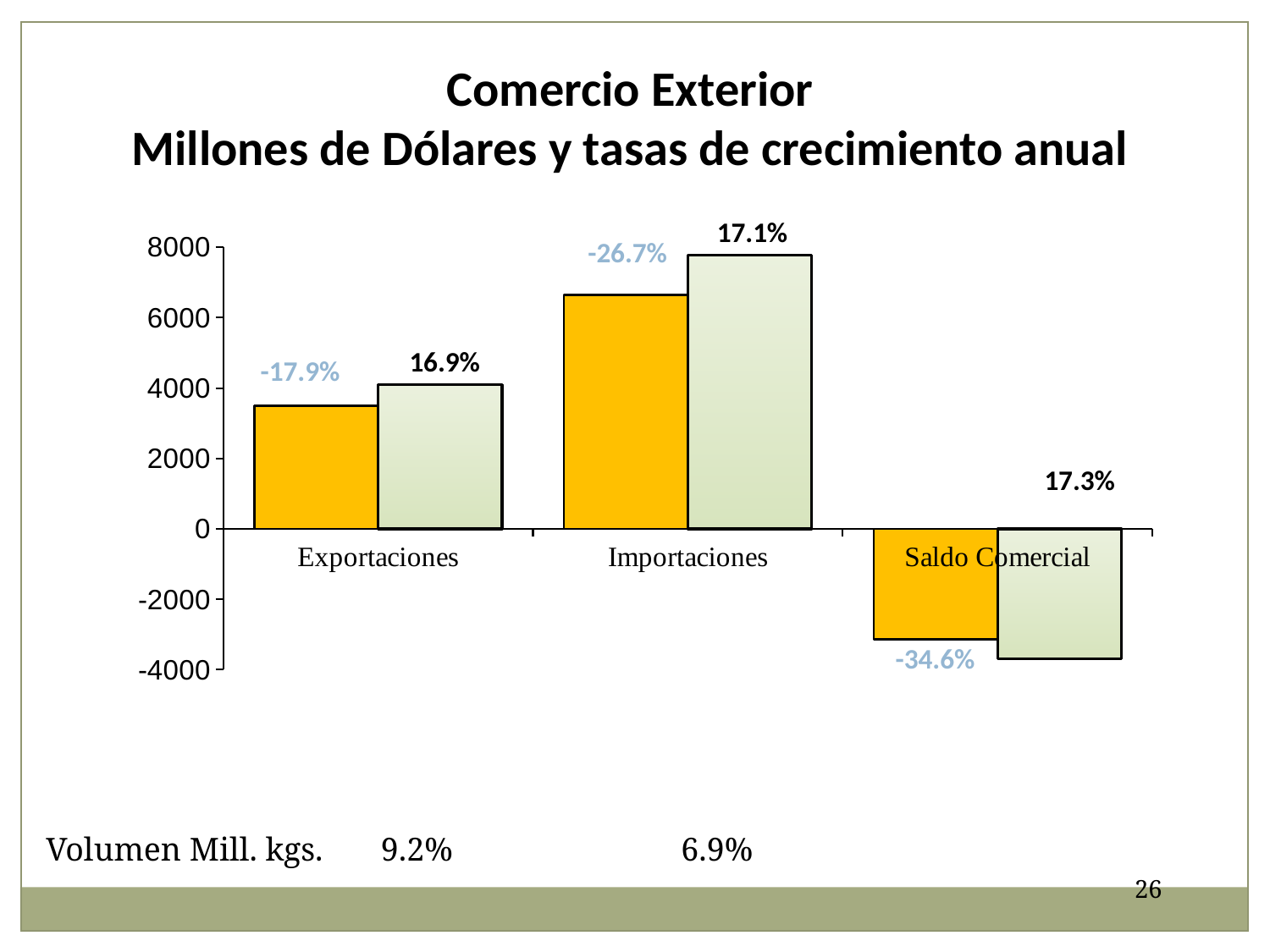
What growth rate label is shown for the orange bar of Importaciones? -26.7% What growth rate label is shown above the green bar for Importaciones? 17.1% Which category has the lowest (negative) bars in the chart? Saldo Comercial Is the value of the orange bar for Importaciones greater or less than 6000? greater Which category has the tallest bars in the chart? Importaciones What growth rate label is shown for the green bar of Saldo Comercial? 17.3% What growth rate label is shown below the orange bar for Saldo Comercial? -34.6% What growth rate label is shown above the orange bar for Exportaciones? -17.9% What is the title of the chart? Comercio Exterior Millones de Dólares y tasas de crecimiento anual What kind of chart is shown on the slide? bar chart How many categories are shown on the x axis of the chart? 3 What growth rate label is shown above the green bar for Exportaciones? 16.9%